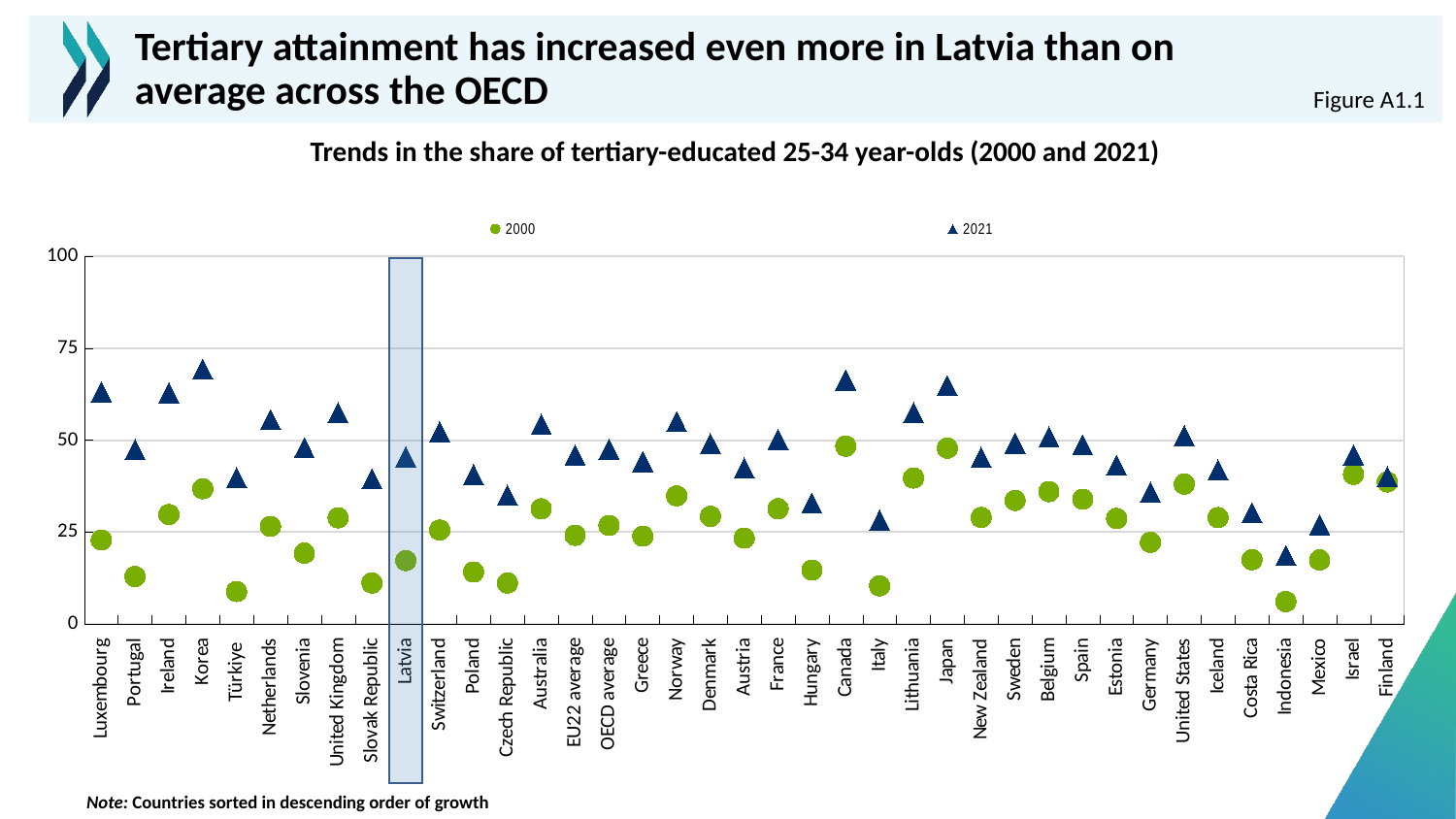
Which is larger, the 2021 value for Korea or the 2021 value for Türkiye? Korea Is the 2021 value for Luxembourg greater or less than 50? greater Which country is highlighted with a shaded box on the chart? Latvia How many countries or averages are shown along the x axis? 39 Which country has the highest value for 2021? Korea Is the 2000 value for Portugal greater or less than 25? less What kind of chart is shown on the slide? Scatter chart Which country has the lowest value for 2000? Indonesia Which country has the lowest value for 2021? Indonesia Which marker shape represents the 2021 series in the legend? Triangle Is the 2000 value for Latvia greater or less than 25? less How many series does the legend list? 2